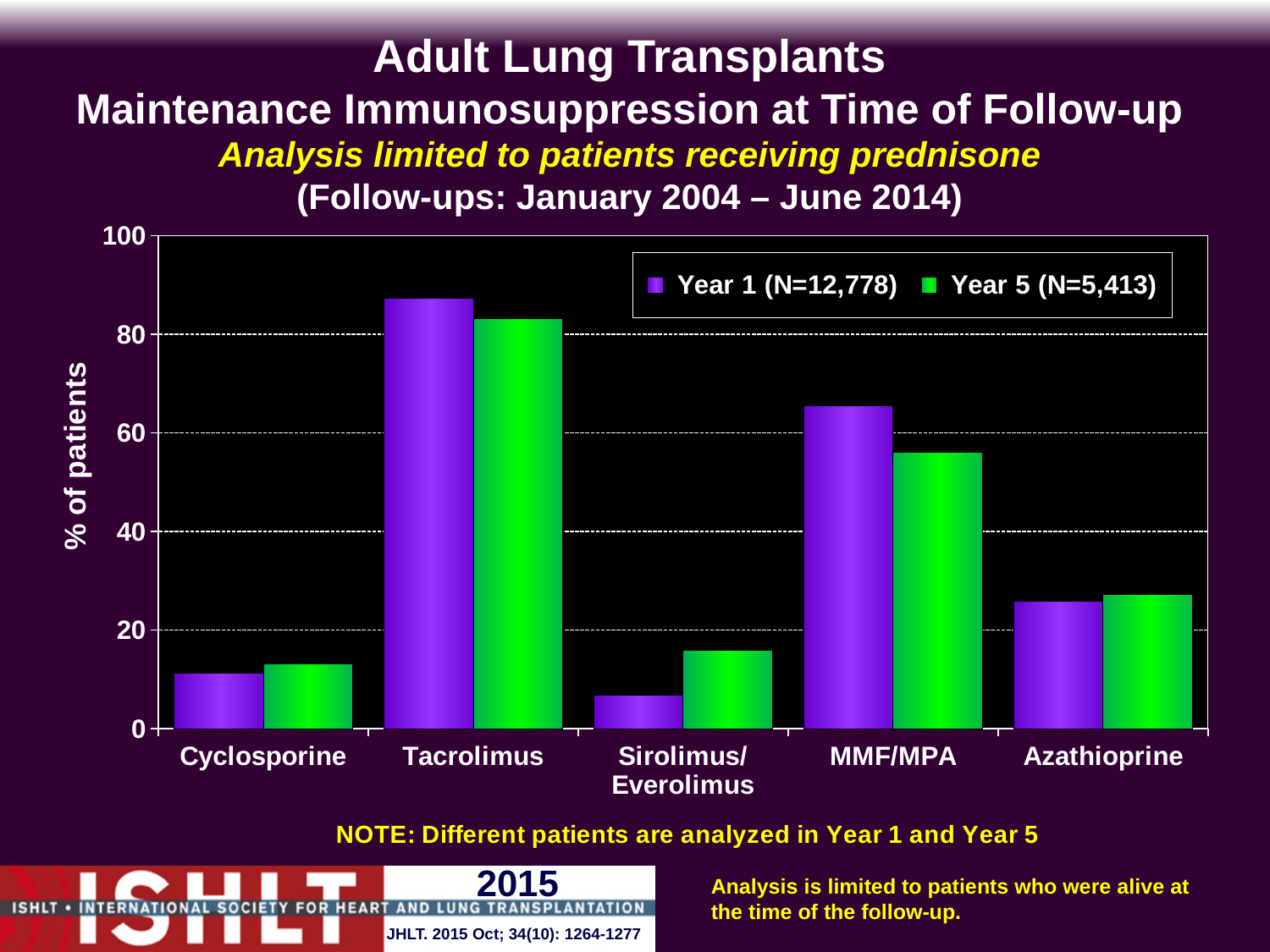
Which drug has the highest Year 1 percentage of patients? Tacrolimus How many series does the legend list? 2 According to the legend, what is the N for the Year 5 series? 5,413 How many drug categories are shown on the x axis? 5 Is the Year 5 value for MMF/MPA greater or less than 60? less Which drug has the lowest Year 1 percentage of patients? Sirolimus/Everolimus For MMF/MPA, which is larger: the Year 1 value or the Year 5 value? Year 1 For Sirolimus/Everolimus, which is larger: the Year 1 value or the Year 5 value? Year 5 Is the Year 1 value for Tacrolimus greater or less than 80? greater For Tacrolimus, which is larger: the Year 1 value or the Year 5 value? Year 1 What kind of chart is shown on the slide? Bar chart Is the Year 1 value for Cyclosporine greater or less than 20? less